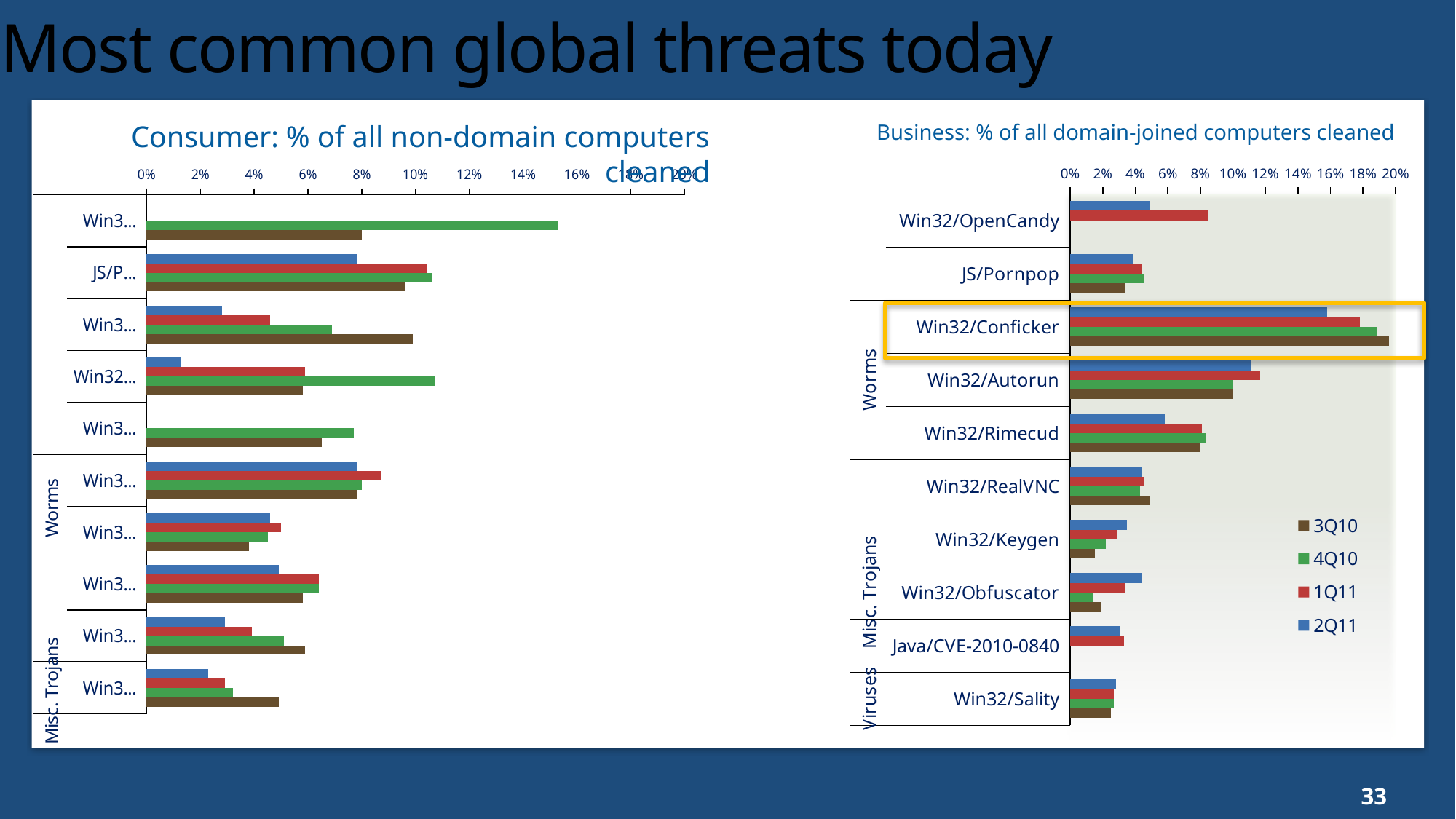
In the Business chart, is the 3Q10 value for Win32/Conficker greater or less than 18%? greater In the Business chart, is the 2Q11 value for Win32/Sality greater or less than 4%? less In the Business chart, which threat has the highest value in 3Q10? Win32/Conficker In the Business chart, how many bars are plotted for Java/CVE-2010-0840? 2 How many series does the legend of the Business chart list? 4 In the Business chart, does the value for Win32/Conficker rise or fall from 3Q10 to 2Q11? fall In the Business chart, is the 2Q11 value for Win32/Autorun greater or less than 10%? greater How many threat categories are plotted in the Business: % of all domain-joined computers cleaned chart? 10 What is the title of the chart on the left side of the slide? Consumer: % of all non-domain computers cleaned What kind of chart is the Business: % of all domain-joined computers cleaned chart? bar chart In the Business chart, which is larger for Win32/OpenCandy: the 1Q11 value or the 2Q11 value? 1Q11